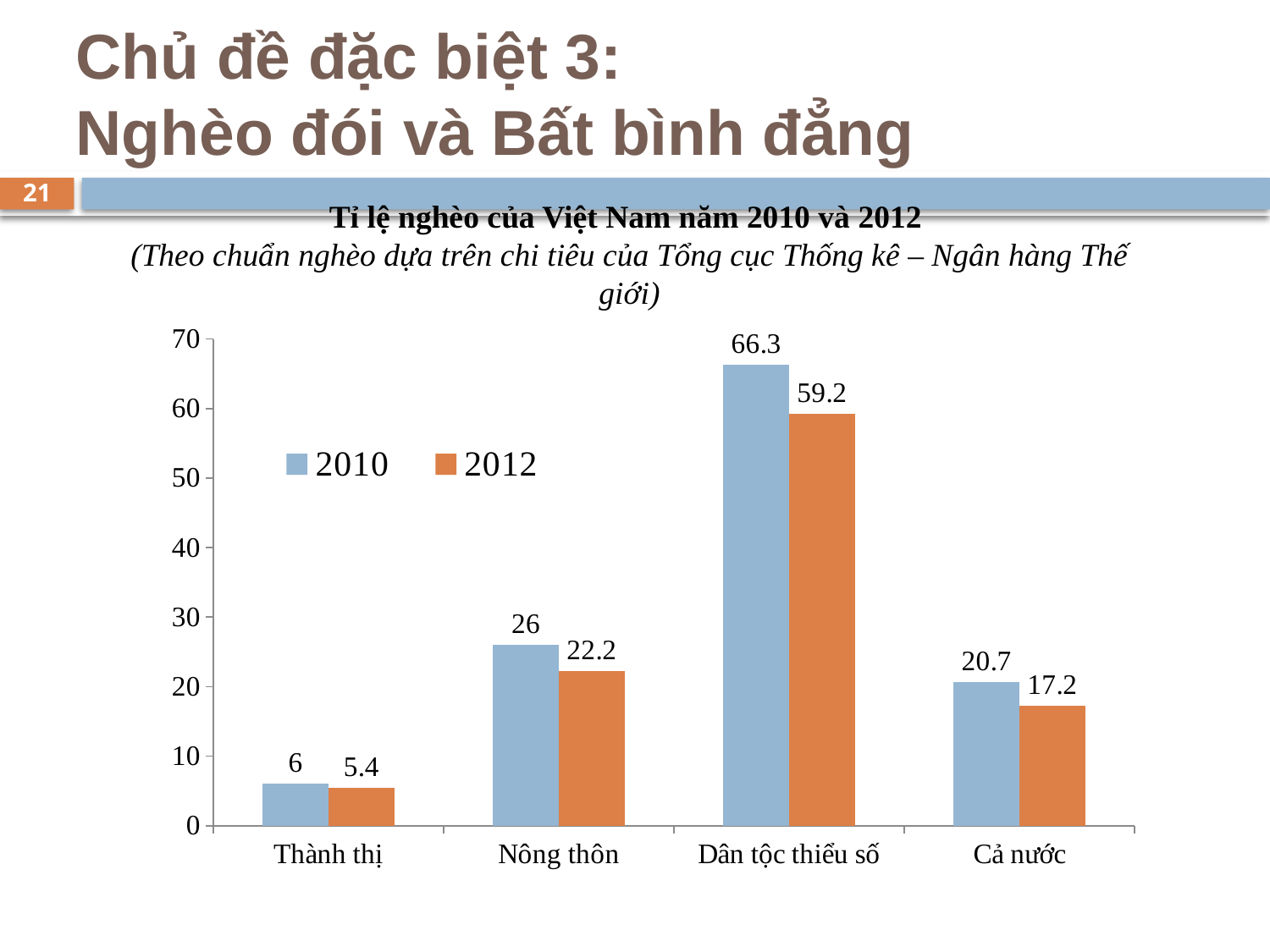
How many series does the legend list? 2 What is the difference between the 2010 and 2012 values for Dân tộc thiểu số? 7.1 What is the 2010 value for Thành thị? 6 What kind of chart is shown on the slide? Bar chart What is the 2010 value for Dân tộc thiểu số? 66.3 Which category has the highest 2012 value? Dân tộc thiểu số Which category has the lowest 2010 value? Thành thị What is the 2012 value for Cả nước? 17.2 How many categories are shown on the x axis? 4 Which is larger for Nông thôn, the 2010 value or the 2012 value? 2010 What is the 2012 value for Nông thôn? 22.2 What is the difference between the 2010 and 2012 values for Cả nước? 3.5